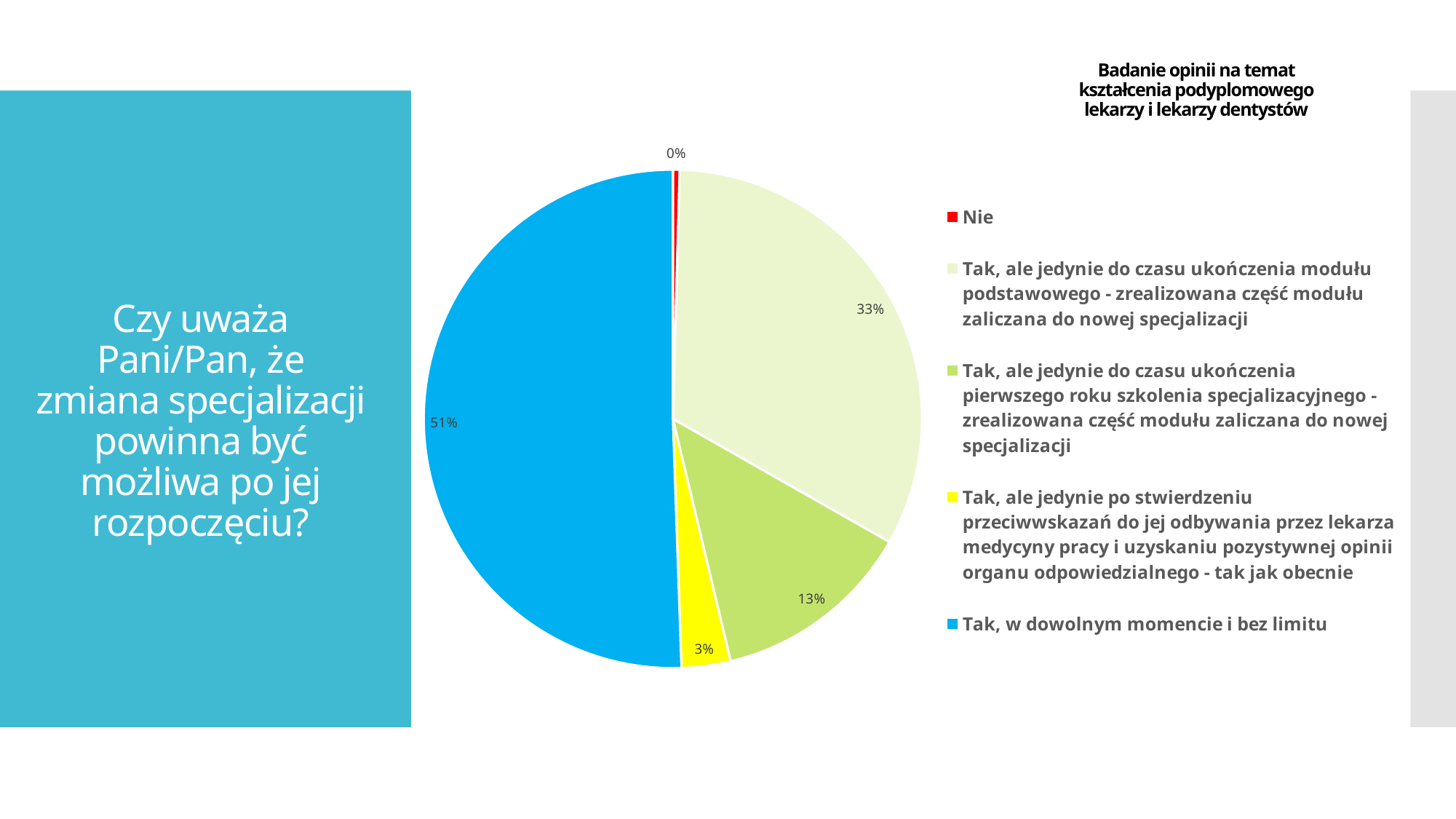
What percentage corresponds to the answer "Tak, ale jedynie do czasu ukończenia pierwszego roku szkolenia specjalizacyjnego"? 13% What kind of chart is shown on the slide? pie chart Which is larger: the share for "Tak, ale jedynie do czasu ukończenia pierwszego roku szkolenia specjalizacyjnego" or the share for "Tak, ale jedynie po stwierdzeniu przeciwwskazań"? Tak, ale jedynie do czasu ukończenia pierwszego roku szkolenia specjalizacyjnego What percentage of respondents answered "Nie"? 0% What share of the pie is labelled for the answer "Tak, ale jedynie do czasu ukończenia modułu podstawowego - zrealizowana część modułu zaliczana do nowej specjalizacji"? 33% What is the difference in percentage points between "Tak, w dowolnym momencie i bez limitu" and "Tak, ale jedynie do czasu ukończenia modułu podstawowego"? 18 percentage points Which answer option has the smallest share of the pie? Nie Which answer option has the largest share of the pie? Tak, w dowolnym momencie i bez limitu How many answer options does the legend list? 5 What percentage of respondents answered "Tak, w dowolnym momencie i bez limitu"? 51% What colour is the slice for "Tak, w dowolnym momencie i bez limitu"? blue What percentage corresponds to the yellow slice, "Tak, ale jedynie po stwierdzeniu przeciwwskazań ... tak jak obecnie"? 3%